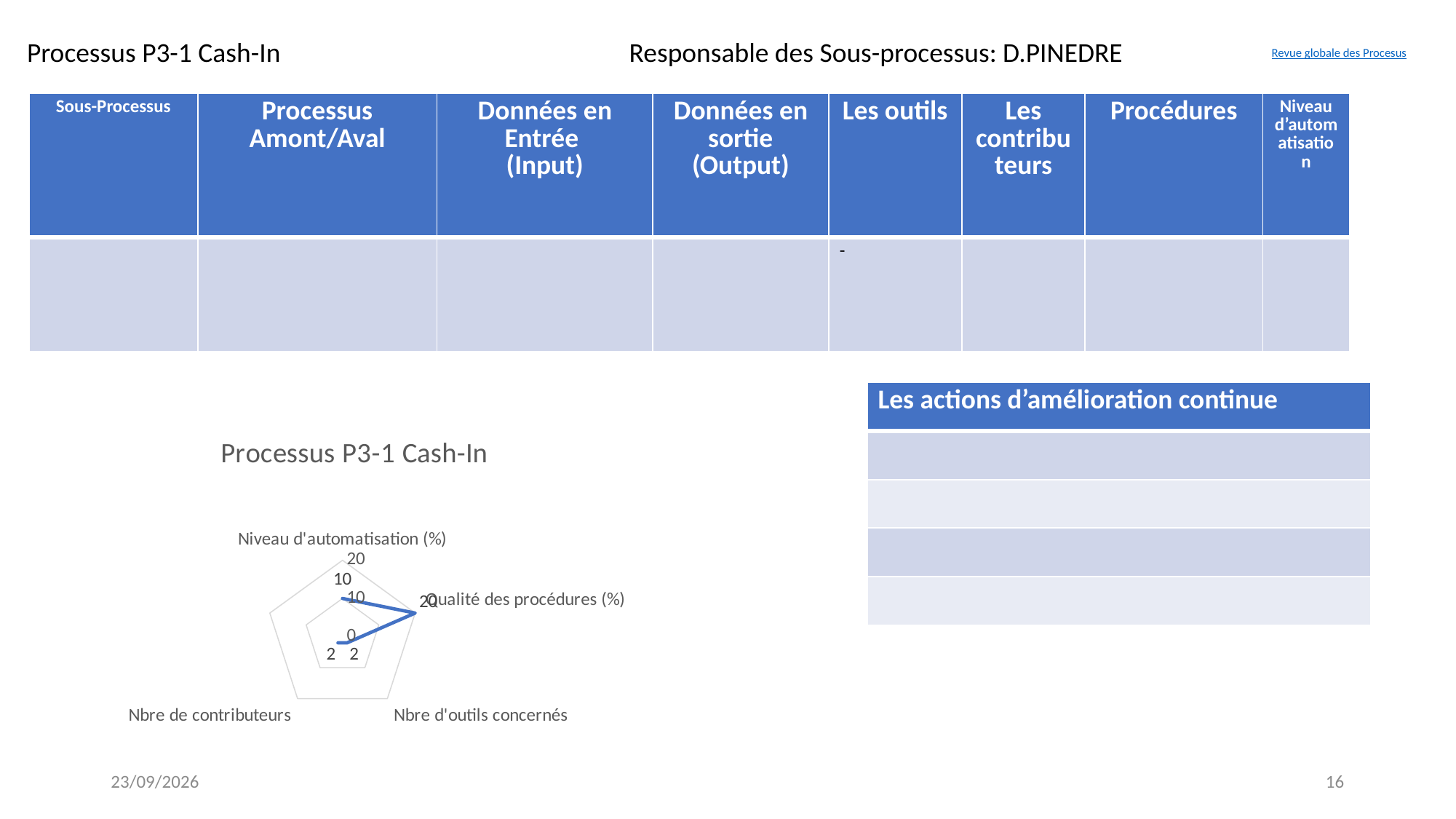
What is the title of the chart? Processus P3-1 Cash-In Is the value for Nbre de contributeurs greater or less than 10? less How many axes does the radar chart have? 5 Which is larger, the value for Qualité des procédures (%) or the value for Niveau d'automatisation (%)? Qualité des procédures (%) Which axis has the highest value? Qualité des procédures (%) Is the value for Nbre d'outils concernés greater or less than 10? less What is the difference between the value for Qualité des procédures (%) and the value for Niveau d'automatisation (%)? 10 What kind of chart is shown on the slide? radar chart What is the value for Nbre d'outils concernés? 2 What is the highest tick value shown on the chart's scale? 20 What is the value for Niveau d'automatisation (%)? 10 What is the value for Qualité des procédures (%)? 20